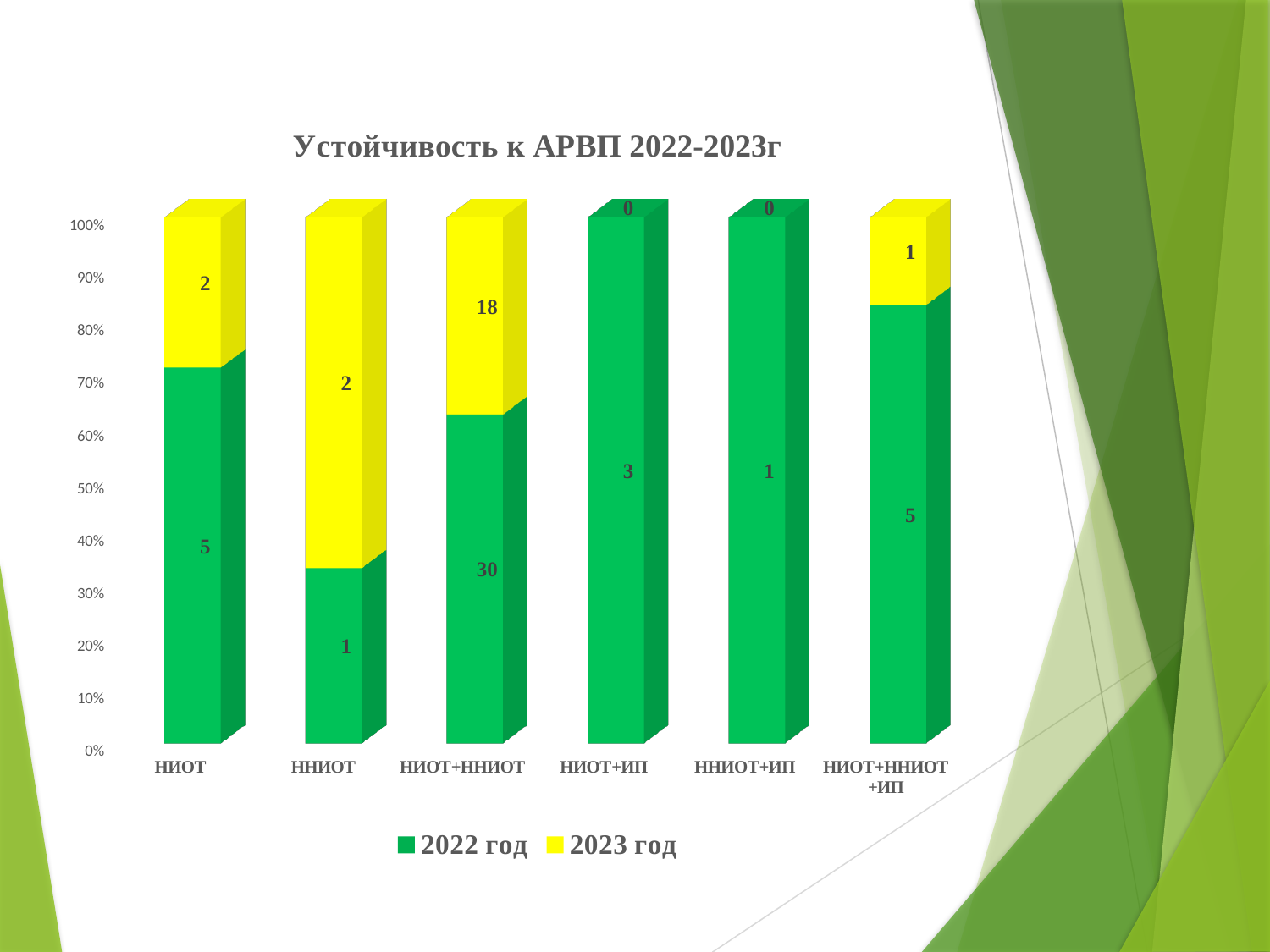
What is the value for 2023 год in the НИОТ+ИП category? 0 What is the value for 2023 год in the НИОТ category? 2 What is the title of the chart? Устойчивость к АРВП 2022-2023г Which category has the highest value for 2023 год? НИОТ+ННИОТ What is the total of the stacked bar for НИОТ? 7 Which category has the highest value for 2022 год? НИОТ+ННИОТ What is the value for 2022 год in the НИОТ+ННИОТ category? 30 How many series does the legend list? 2 How many categories are shown on the x axis? 6 In the ННИОТ category, which series has the larger value, 2022 год or 2023 год? 2023 год What is the value for 2022 год in the ННИОТ category? 1 What is the difference between the 2022 год and 2023 год values in the НИОТ+ННИОТ category? 12